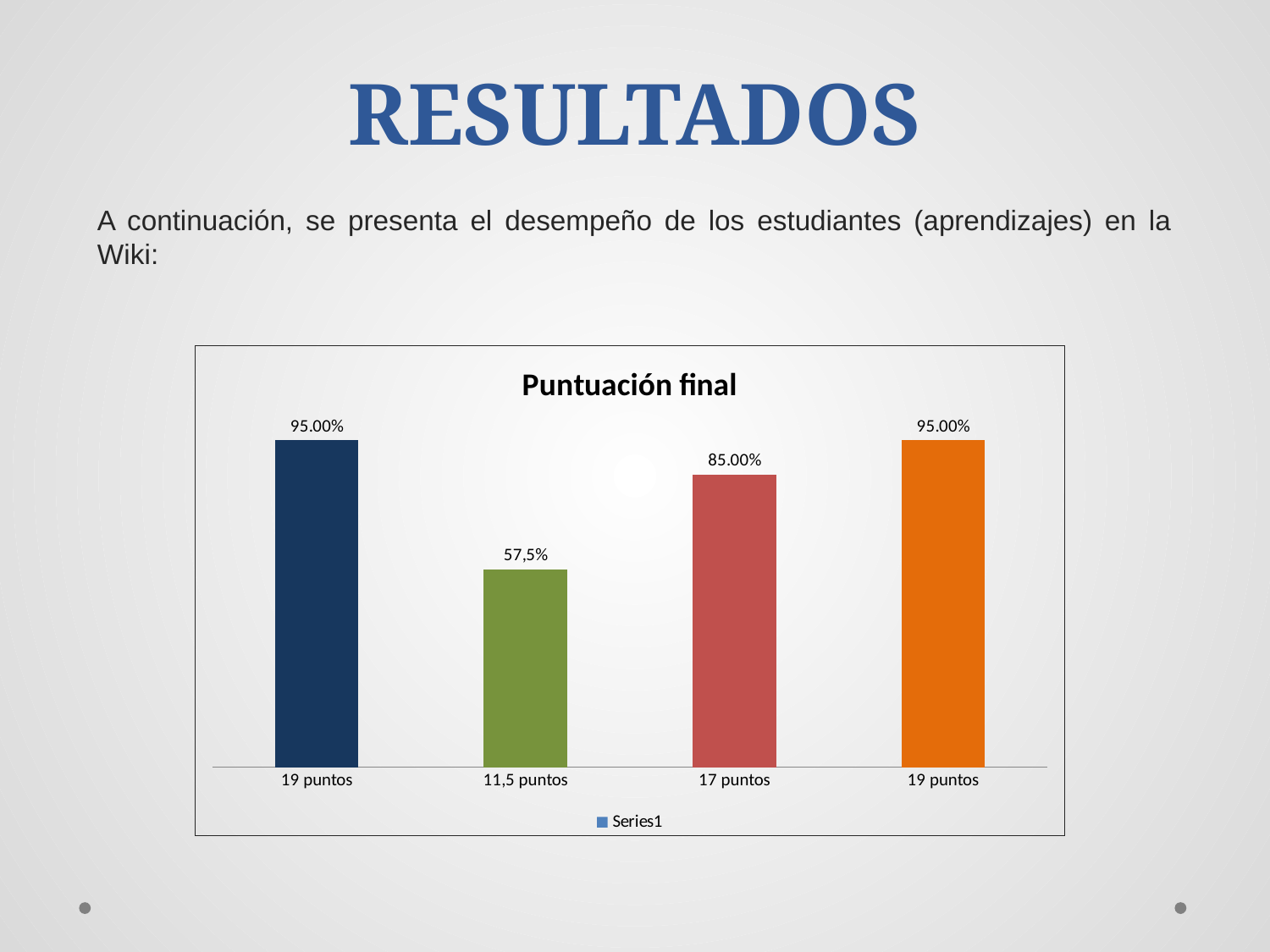
How many series does the legend list? 1 Which category has the lowest value in the chart? 11,5 puntos What is the difference between the value for 19 puntos and the value for 17 puntos? 10 percentage points What is the highest value shown in the chart? 95.00% What value is shown above each of the bars labelled 19 puntos? 95.00% Which is larger, the value for 17 puntos or the value for 11,5 puntos? 17 puntos What is the difference between the value for 17 puntos and the value for 11,5 puntos? 27.5 percentage points What is the value shown for the bar labelled 17 puntos? 85.00% How many bars are shown in the chart? 4 What kind of chart is shown on the slide? Bar chart What is the value shown for the bar labelled 11,5 puntos? 57,5% What is the title of the chart? Puntuación final